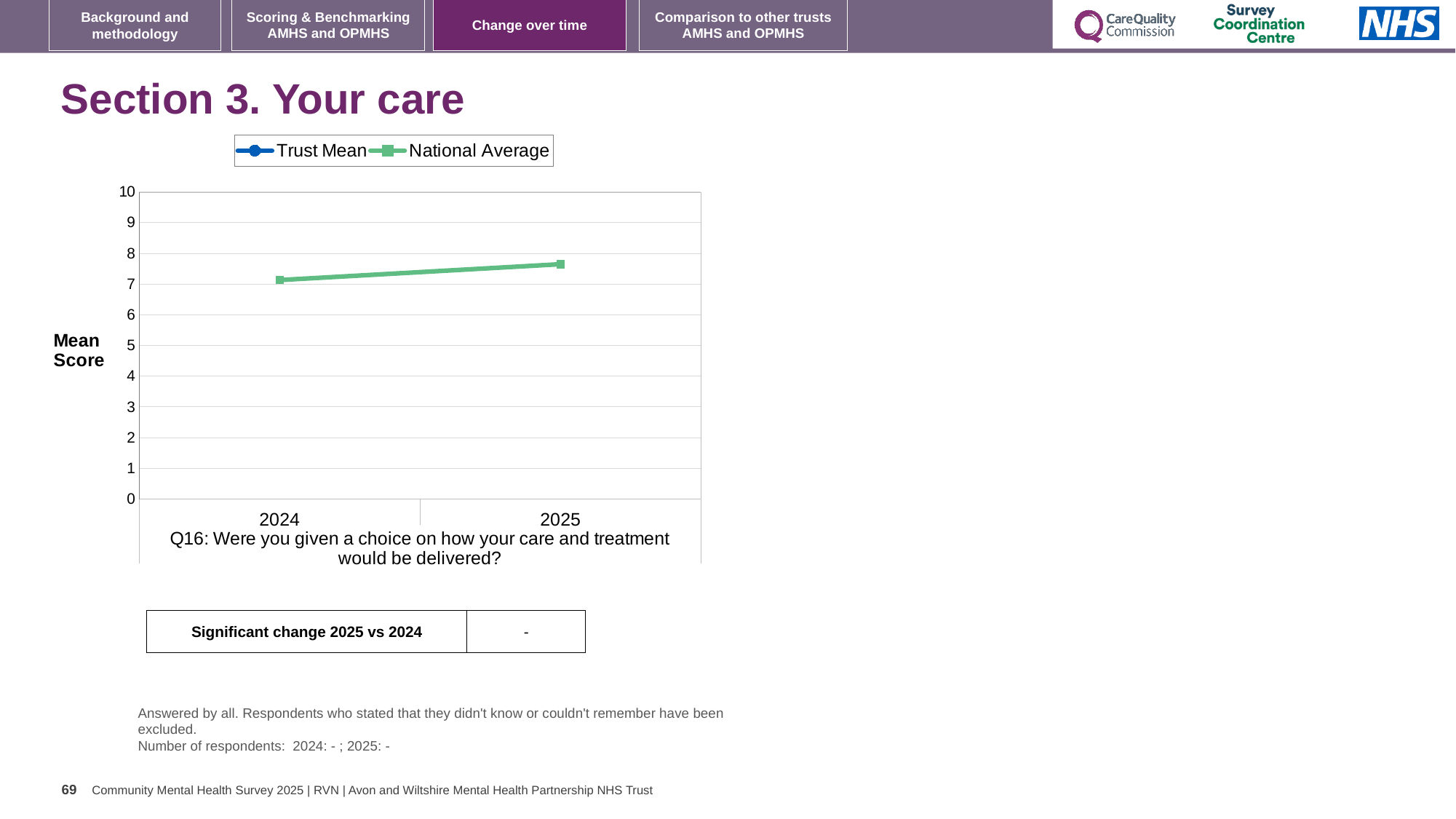
Is the National Average value for 2025 greater or less than 8? less Is the National Average value for 2024 greater or less than 6? greater How many years are shown on the x axis of the chart? 2 Does the National Average line rise or fall from 2024 to 2025? rise What kind of chart is shown on the slide? line chart Which survey question does the chart relate to? Q16: Were you given a choice on how your care and treatment would be delivered? Is the National Average value for 2024 greater or less than 8? less How many series does the chart legend list? 2 What is the label on the y axis of the chart? Mean Score Which year has the higher National Average value, 2024 or 2025? 2025 What is the highest value shown on the y axis of the chart? 10